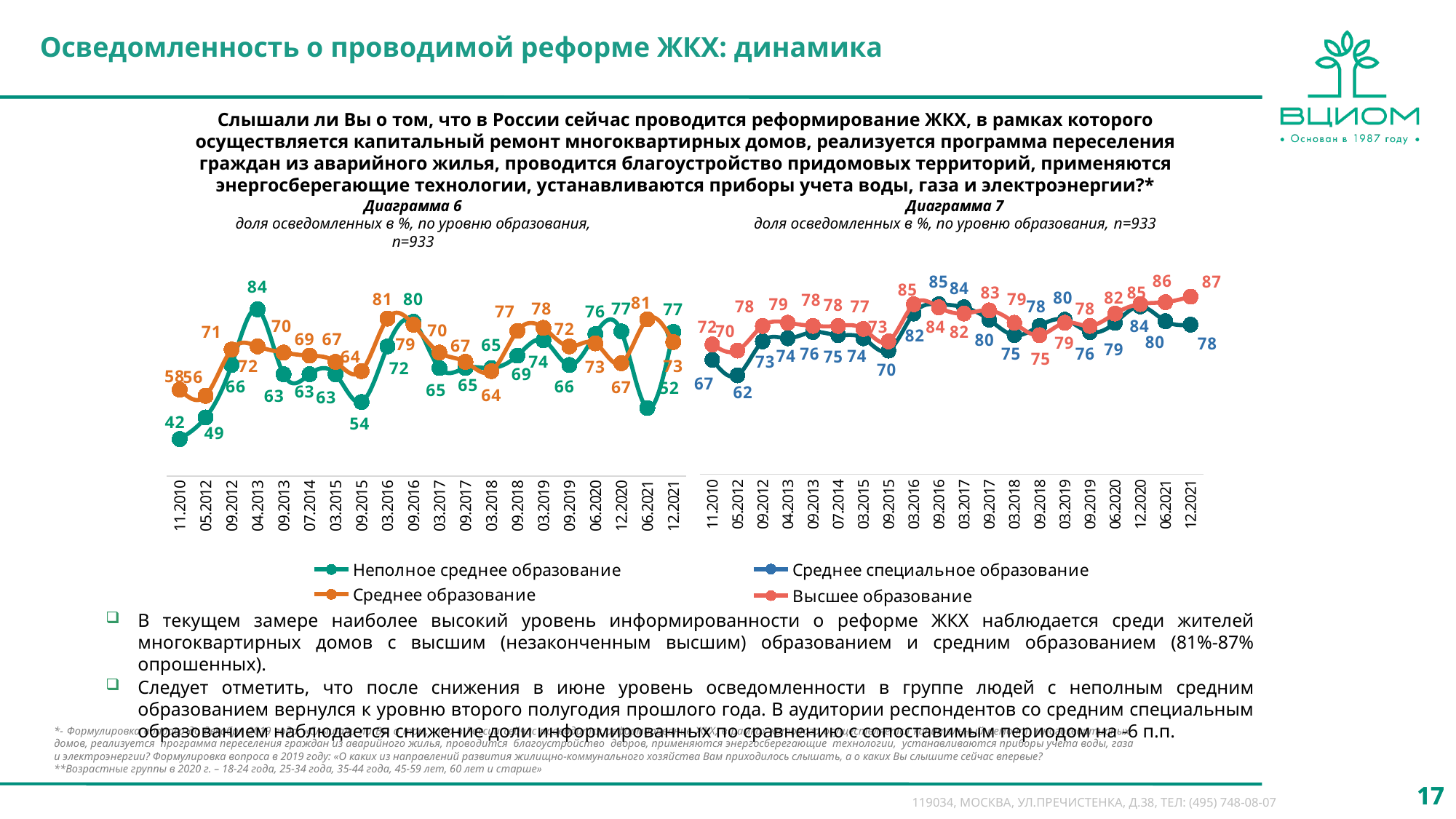
In Диаграмма 6 (left chart), what is the value for Неполное среднее образование at 04.2013? 84 How many time points are plotted along the x axis of Диаграмма 6 (left chart)? 20 In Диаграмма 6 (left chart), which series has the higher value at 06.2021: Неполное среднее образование or Среднее образование? Среднее образование In Диаграмма 7 (right chart), what is the difference between Высшее образование and Среднее специальное образование at 12.2021? 9 In Диаграмма 6 (left chart), at which date does Неполное среднее образование reach its highest value? 04.2013 How many series does the legend of Диаграмма 7 (right chart) list? 2 In Диаграмма 6 (left chart), what is the value for Среднее образование at 03.2016? 81 In Диаграмма 7 (right chart), at which date is the value for Среднее специальное образование lowest? 05.2012 In Диаграмма 7 (right chart), what is the value for Высшее образование at 12.2021? 87 In Диаграмма 6 (left chart), at which date is the value for Неполное среднее образование lowest? 11.2010 What kind of chart is Диаграмма 6 on the left of the slide? line chart In Диаграмма 7 (right chart), at which date does Высшее образование reach its highest value? 12.2021